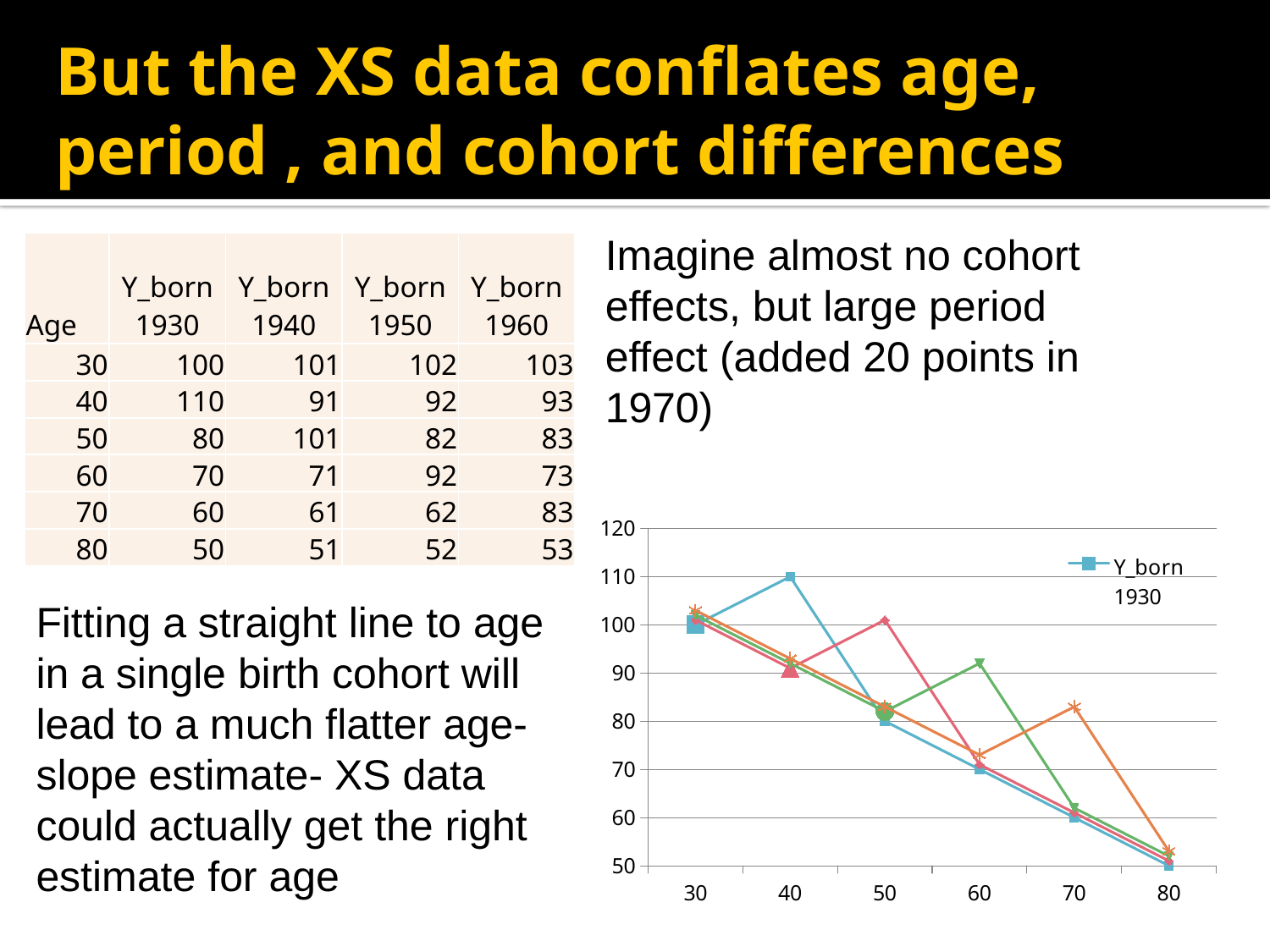
Which series name is readable in the chart's legend? Y_born 1930 What is the value of the Y_born 1930 series at age 30 in the chart? 100 What is the difference between the Y_born 1930 values at age 40 and age 80? 60 At which age does the Y_born 1930 series reach its lowest value in the chart? 80 Is the Y_born 1930 value at age 40 greater or less than 100? greater What is the value of the Y_born 1930 series at age 80 in the chart? 50 What kind of chart is shown on the slide? line chart How many age categories are shown on the x axis of the chart? 6 Do the values in the chart generally rise or fall as age increases from 30 to 80? fall Which is larger for the Y_born 1930 series: the value at age 40 or the value at age 50? age 40 What is the value of the Y_born 1930 series at age 40 in the chart? 110 At which age does the Y_born 1930 series reach its highest value in the chart? 40